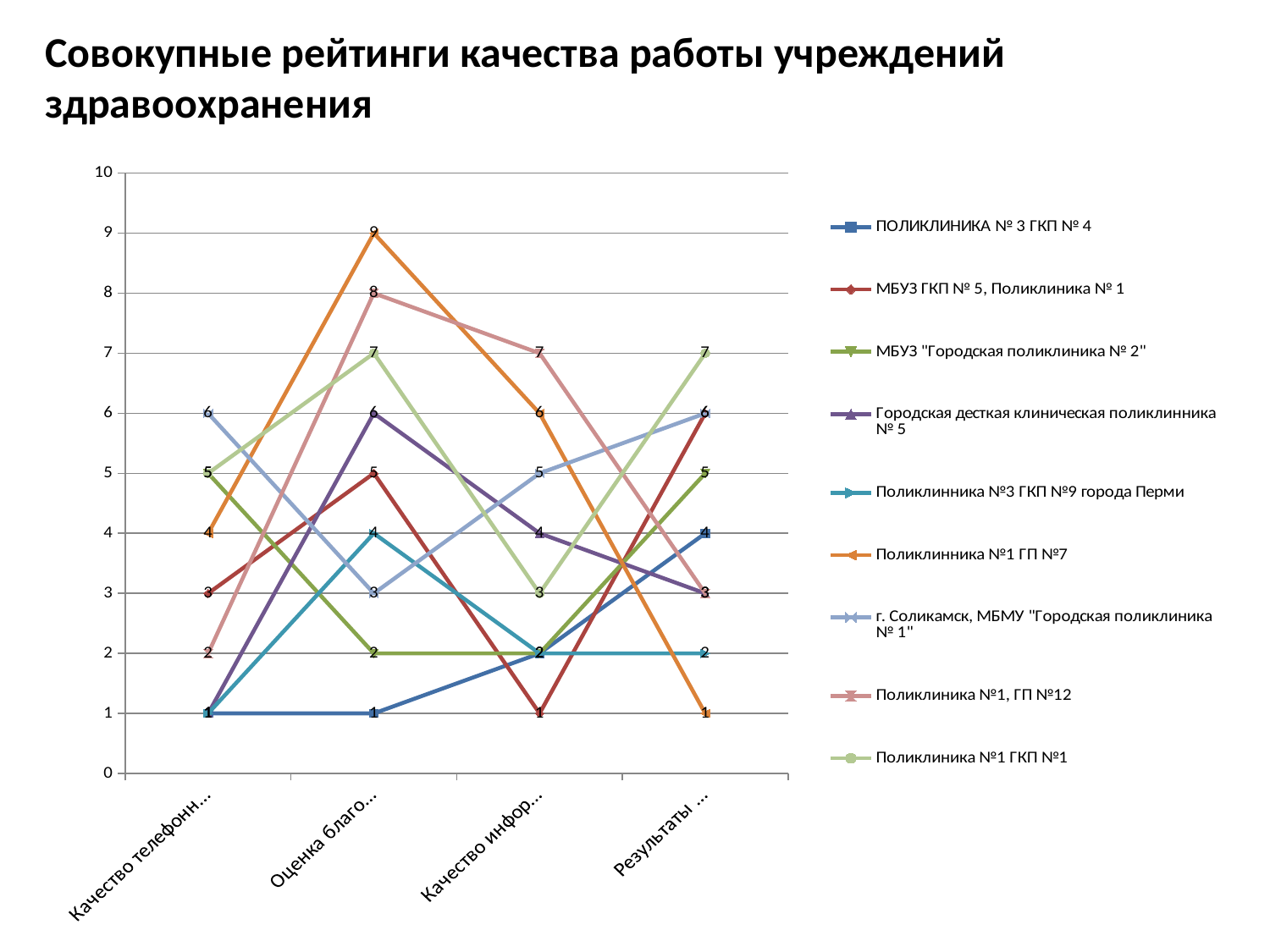
Which series has the highest value at the second category on the x axis (Оценка благо...)? Поликлинника №1 ГП №7 Do the values for ПОЛИКЛИНИКА № 3 ГКП № 4 rise or fall from the first category to the last category on the x axis? rise Is the value for Поликлиника №1, ГП №12 at the second category on the x axis (Оценка благо...) greater or less than 5? greater What is the value for ПОЛИКЛИНИКА № 3 ГКП № 4 at the last category on the x axis (Результаты ...)? 4 What is the value for Поликлинника №1 ГП №7 at the second category on the x axis (Оценка благо...)? 9 What is the difference between the values of Поликлинника №1 ГП №7 and ПОЛИКЛИНИКА № 3 ГКП № 4 at the second category on the x axis (Оценка благо...)? 8 What kind of chart is shown on the slide? line chart Which series has the lowest value at the last category on the x axis (Результаты ...)? Поликлинника №1 ГП №7 At the first category on the x axis (Качество телефонн...), which is larger: the value for г. Соликамск, МБМУ "Городская поликлиника № 1" or the value for Поликлиника №1, ГП №12? г. Соликамск, МБМУ "Городская поликлиника № 1" What is the value for Поликлиника №1, ГП №12 at the third category on the x axis (Качество инфор...)? 7 How many series does the legend list? 9 How many categories are plotted along the x axis? 4